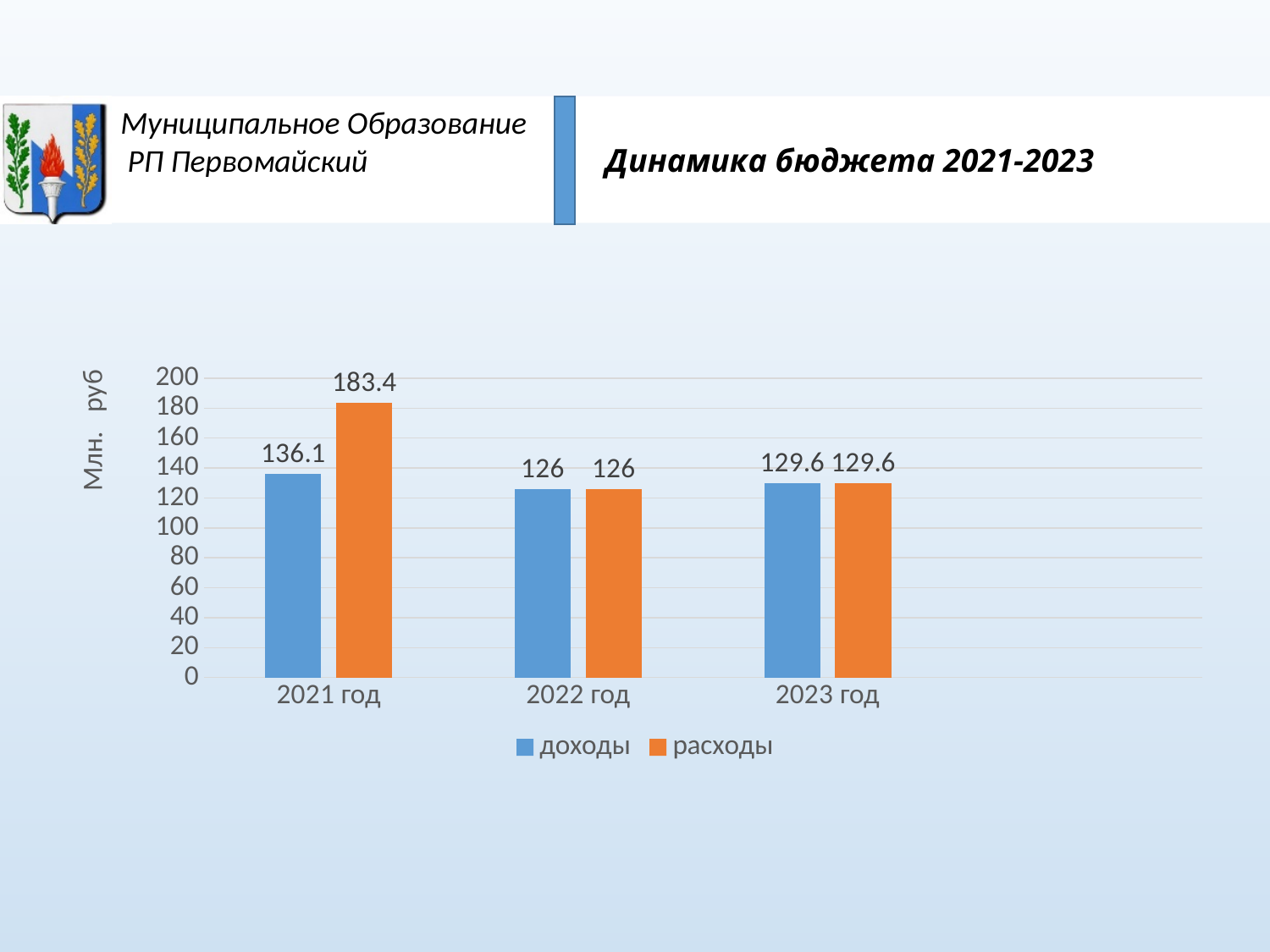
What is the value of расходы for 2021 год? 183.4 How many years are shown on the x axis? 3 What is the value of доходы for 2021 год? 136.1 What is the difference between расходы and доходы in 2021 год? 47.3 How many series does the legend list? 2 Is the value of расходы for 2021 год greater or less than 160? greater Which is larger in 2021 год, доходы or расходы? расходы What type of chart is shown on the slide? bar chart What is the value of расходы for 2023 год? 129.6 In which year is расходы highest? 2021 год What is the value of доходы for 2022 год? 126 In which year is доходы lowest? 2022 год